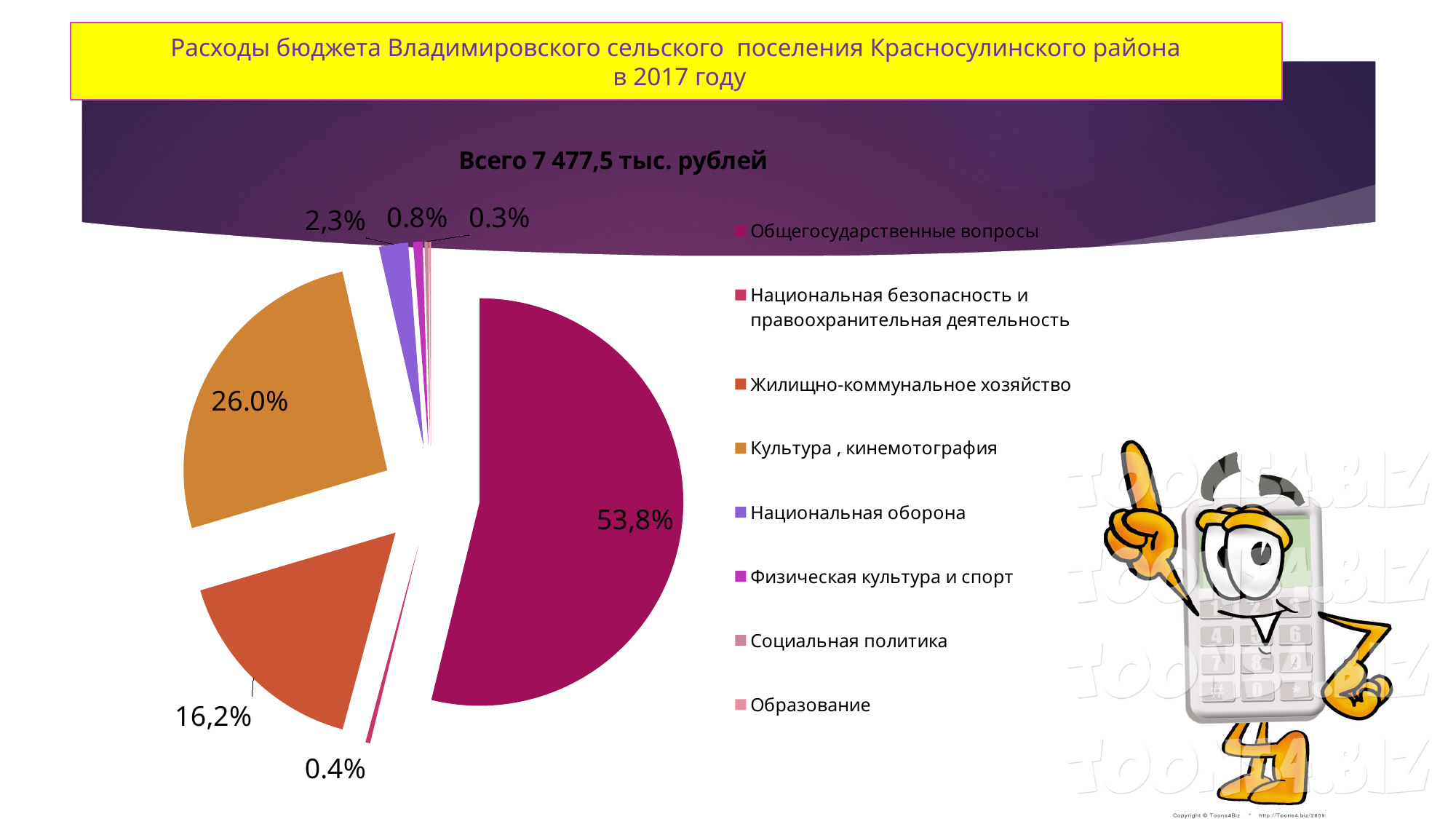
By how many percentage points does the share of Общегосударственные вопросы exceed the share of Культура, кинемотография? 27,8% Which category has the largest share of the budget expenses? Общегосударственные вопросы What share of the budget expenses goes to Физическая культура и спорт? 0.8% What share of the budget expenses goes to Общегосударственные вопросы? 53,8% What total amount of budget expenses is stated above the pie chart? 7 477,5 тыс. рублей Which has a larger share: Культура, кинемотография or Жилищно-коммунальное хозяйство? Культура, кинемотография What kind of chart is shown on the slide? pie chart How many categories does the legend of the pie chart list? 8 What share of the budget expenses goes to Национальная оборона? 2,3% What share of the budget expenses goes to Культура, кинемотография? 26.0% What share of the budget expenses goes to Жилищно-коммунальное хозяйство? 16,2% What share of the budget expenses goes to Национальная безопасность и правоохранительная деятельность? 0.4%